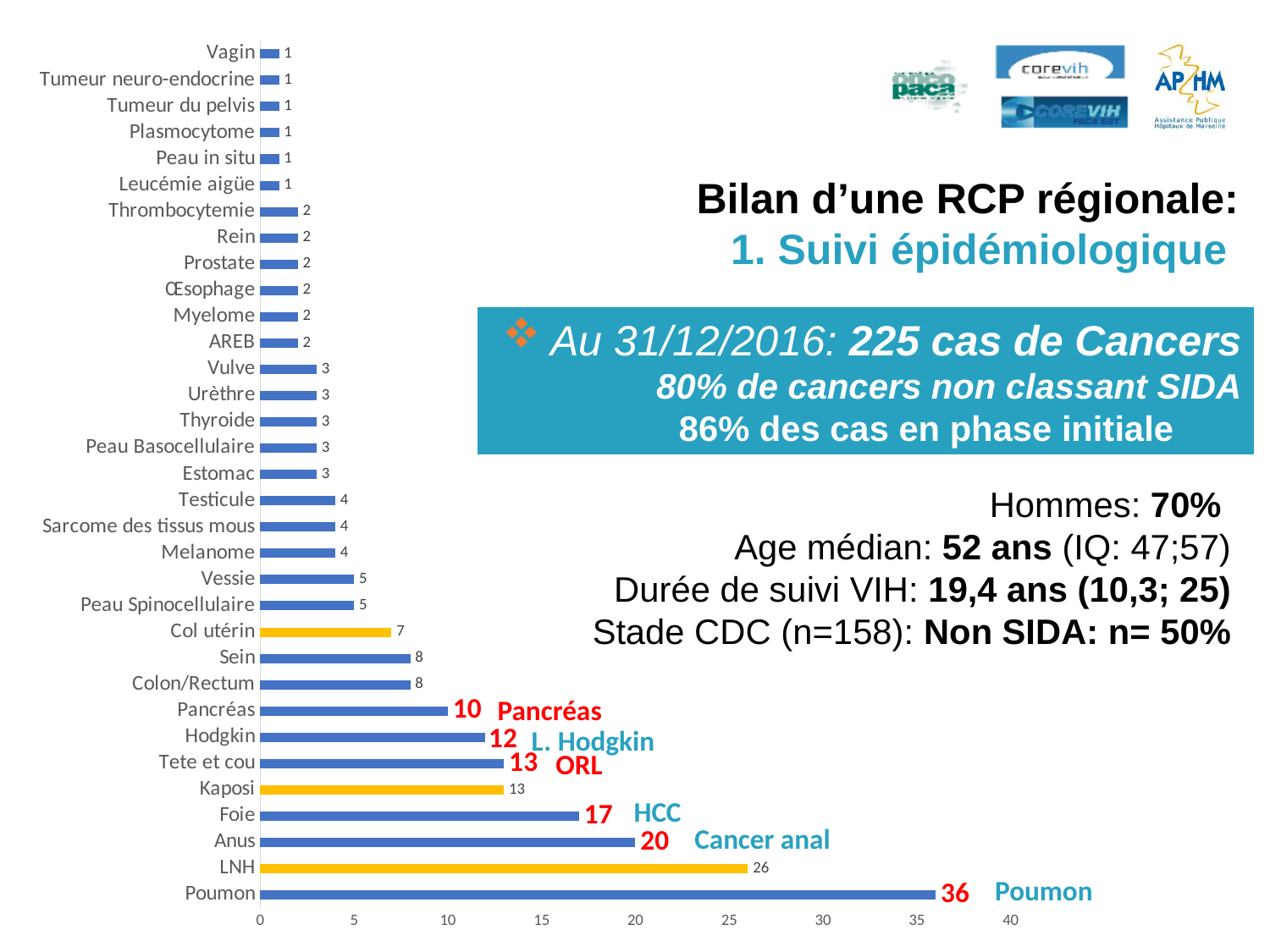
What is the value for Kaposi? 13 What is the value for Poumon? 36 What is the value for LNH? 26 Which category has the highest value? Poumon What type of chart is shown on the slide? bar chart Which is larger, the value for Hodgkin or the value for Pancréas? Hodgkin What is the value for Col utérin? 7 What is the value for Anus? 20 What is the difference between the values for Poumon and LNH? 10 How many categories are plotted in the chart? 33 Which categories are shown with yellow bars instead of blue? Col utérin, Kaposi, LNH What is the difference between the values for Anus and Foie? 3